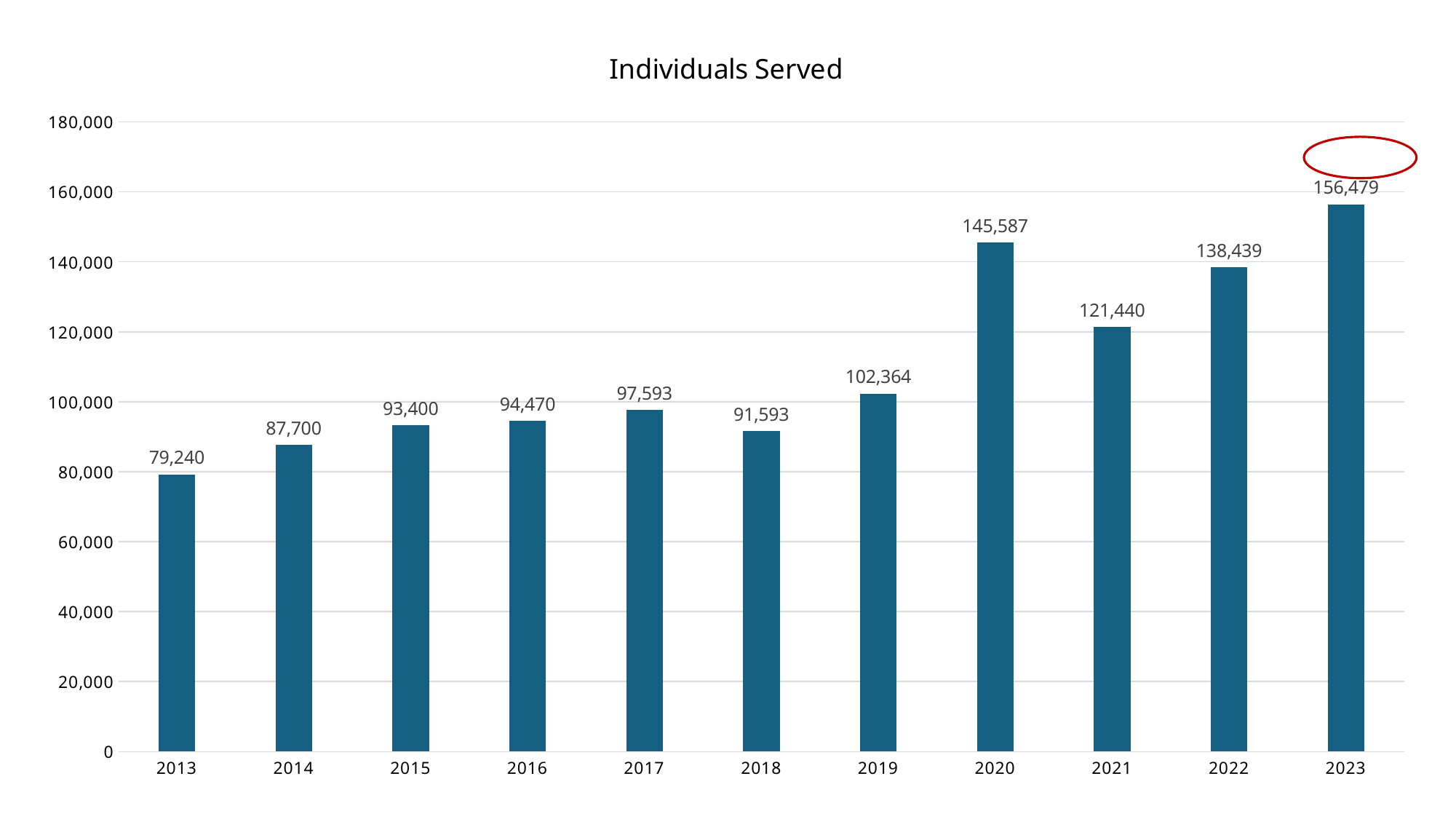
How many years are shown on the x axis? 11 What is the value for 2020? 145,587 Which year has the highest number of individuals served? 2023 What is the value for 2023? 156,479 What is the difference between the values for 2023 and 2022? 18,040 What is the difference between the values for 2020 and 2019? 43,223 Which year has the lowest number of individuals served? 2013 What kind of chart is this? bar chart Which is larger, the value for 2017 or the value for 2018? 2017 What is the value for 2013? 79,240 What is the title of the chart? Individuals Served Is the value for 2021 greater or less than 120,000? greater